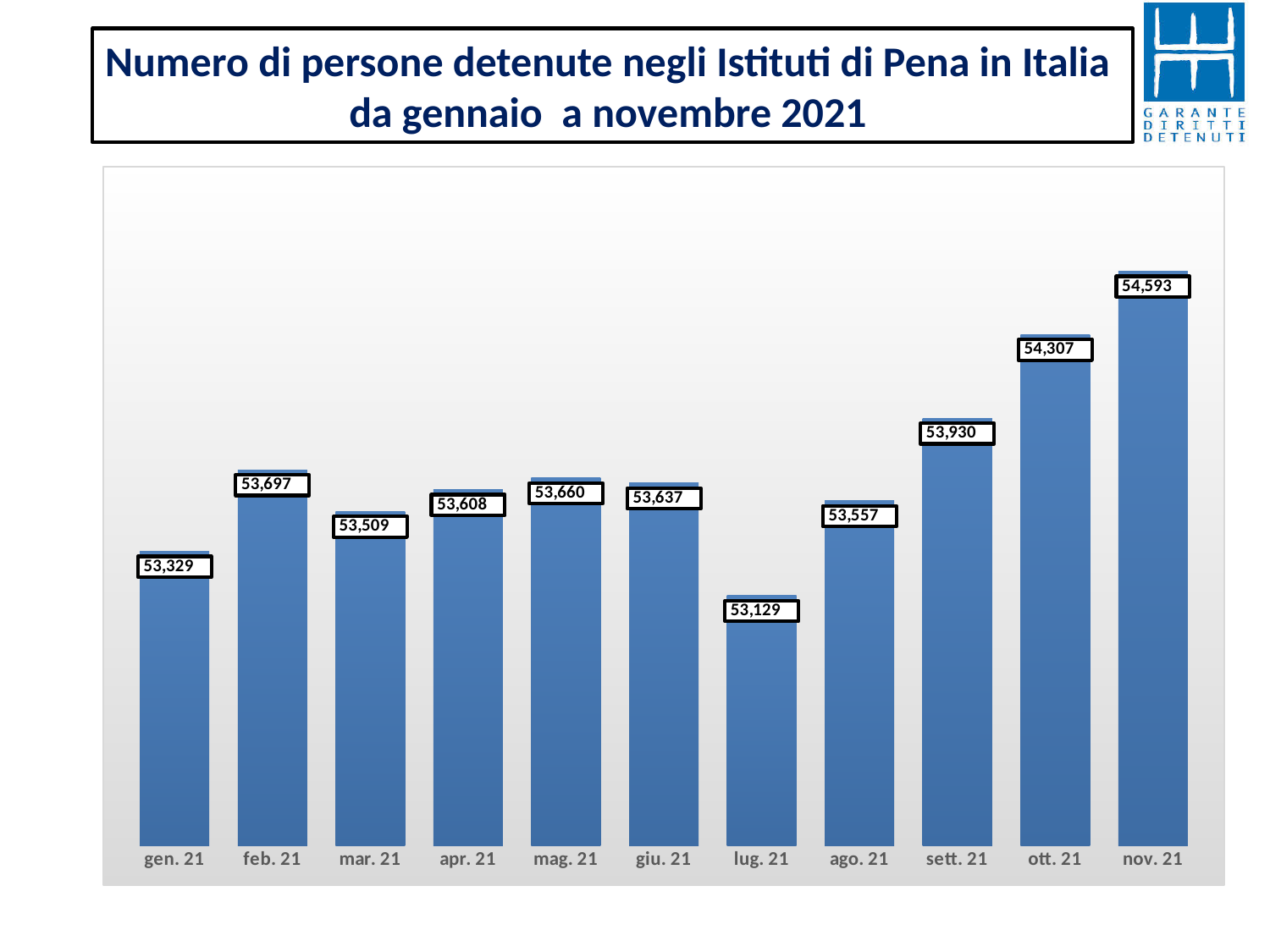
Which month has the highest value? nov. 21 What is the number of detained persons shown for gen. 21? 53,329 How many months are shown on the x axis? 11 What is the difference between the values for sett. 21 and ago. 21? 373 What value is shown for ott. 21? 54,307 Do the values rise or fall from ago. 21 to nov. 21? rise What kind of chart is this? bar chart Which month has the lowest value? lug. 21 Which is larger, the value for mag. 21 or the value for giu. 21? mag. 21 Which is larger, the value for feb. 21 or the value for mar. 21? feb. 21 What value is shown for lug. 21? 53,129 What is the difference between the values for nov. 21 and gen. 21? 1,264